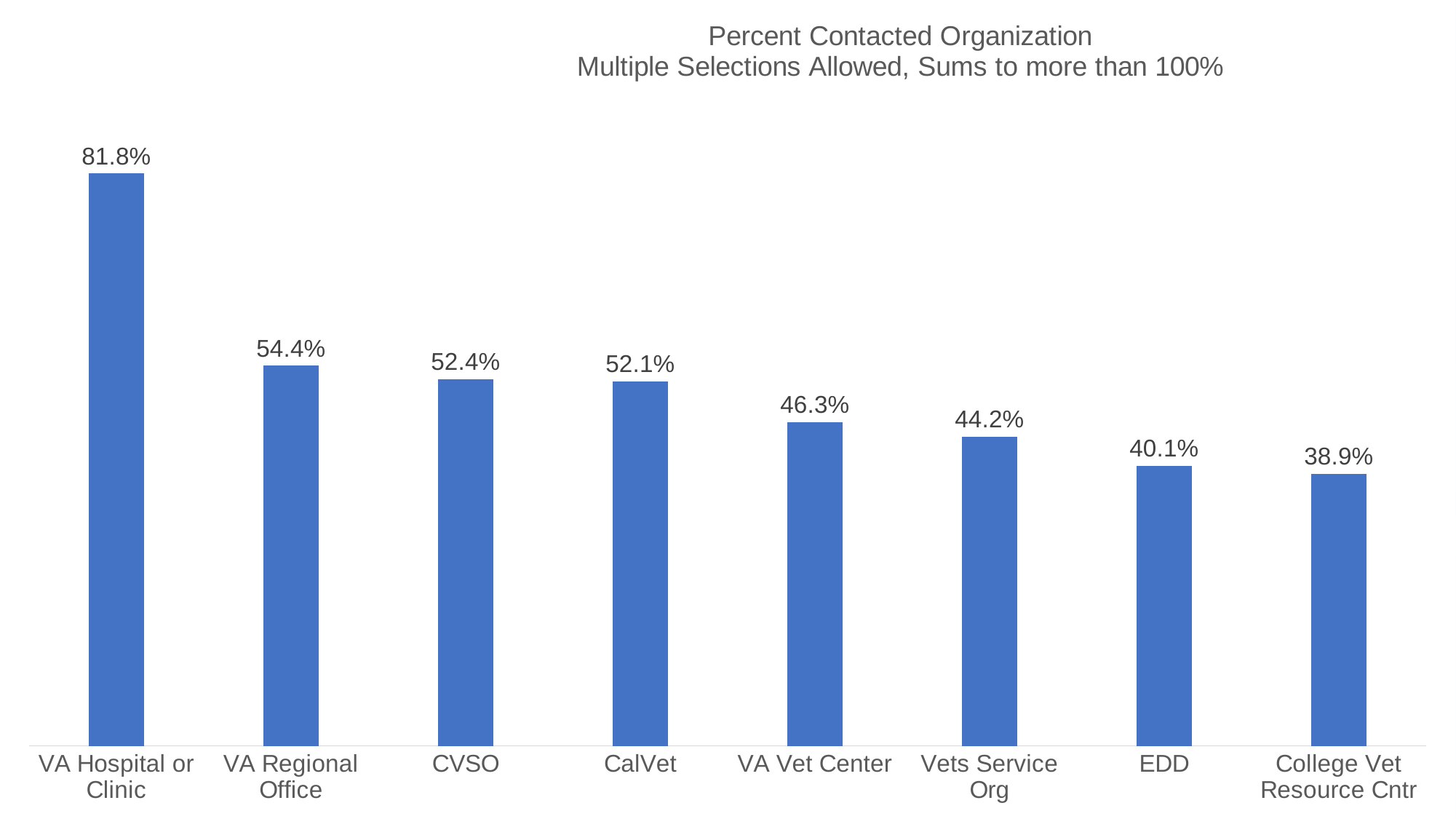
What kind of chart is this? Bar chart Do the values rise or fall from left to right across the chart? Fall Which is larger, the value for VA Regional Office or the value for VA Vet Center? VA Regional Office What percent contacted the VA Hospital or Clinic? 81.8% What is the value for CalVet? 52.1% How many organizations are shown in the chart? 8 What is the difference between the VA Hospital or Clinic and the VA Regional Office values? 27.4% What is the value for EDD? 40.1% What is the difference between the VA Vet Center and Vets Service Org values? 2.1% Which organization has the lowest percent contacted? College Vet Resource Cntr Which organization has the highest percent contacted? VA Hospital or Clinic What is the title of the chart? Percent Contacted Organization Multiple Selections Allowed, Sums to more than 100%